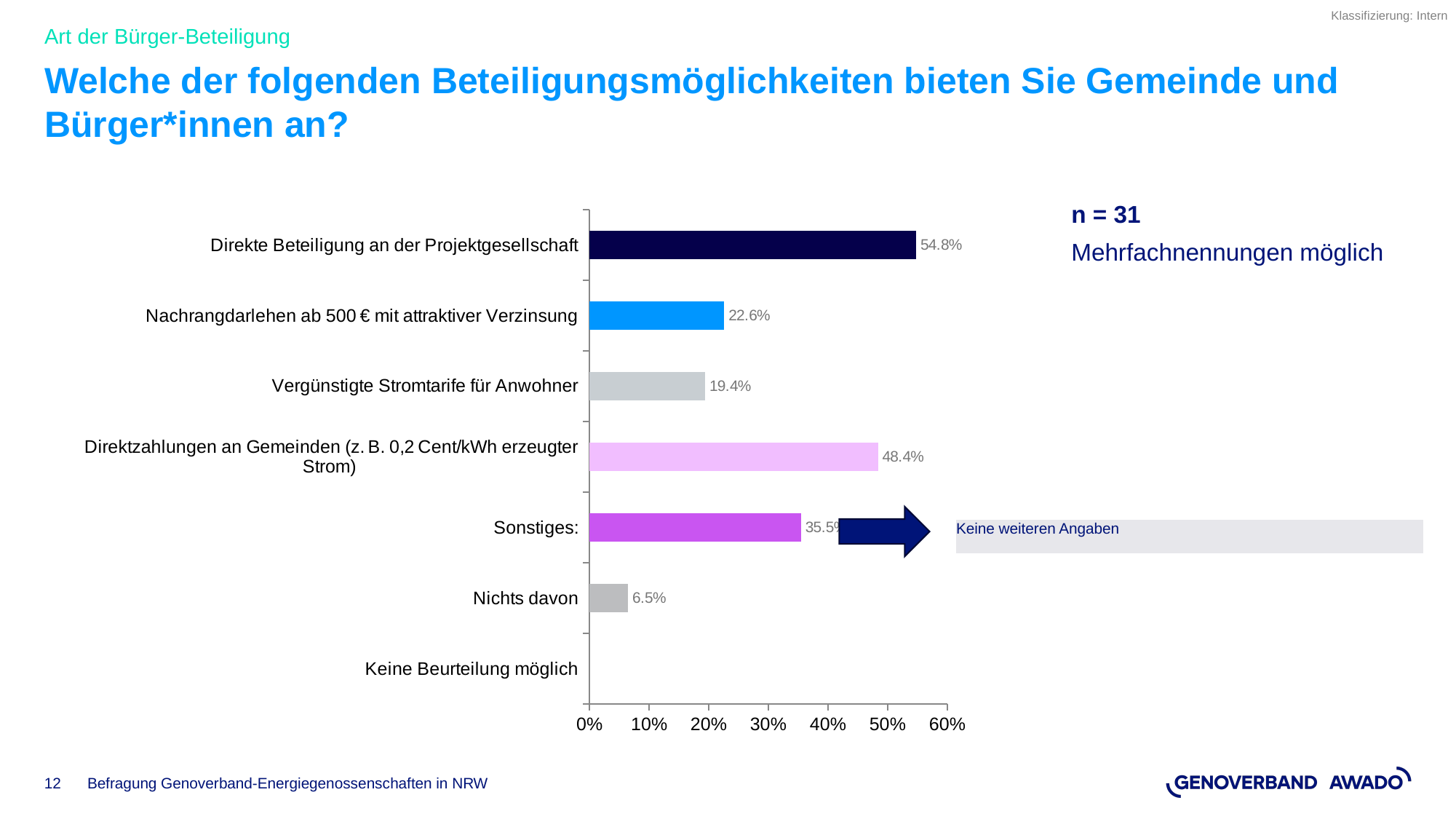
What is the value for "Vergünstigte Stromtarife für Anwohner"? 19.4% Which is larger: "Sonstiges" or "Nachrangdarlehen ab 500 € mit attraktiver Verzinsung"? Sonstiges What is the difference between "Direkte Beteiligung an der Projektgesellschaft" and "Direktzahlungen an Gemeinden"? 6.4 percentage points Which category has the highest value? Direkte Beteiligung an der Projektgesellschaft What kind of chart is shown on the slide? bar chart How many categories are listed on the chart's axis? 7 What is the value for "Nachrangdarlehen ab 500 € mit attraktiver Verzinsung"? 22.6% What sample size (n) is stated next to the chart? n = 31 Among the categories with a printed value, which has the lowest value? Nichts davon What is the value for "Nichts davon"? 6.5% Is the value for "Sonstiges" greater or less than 30%? greater What is the value for "Direkte Beteiligung an der Projektgesellschaft"? 54.8%